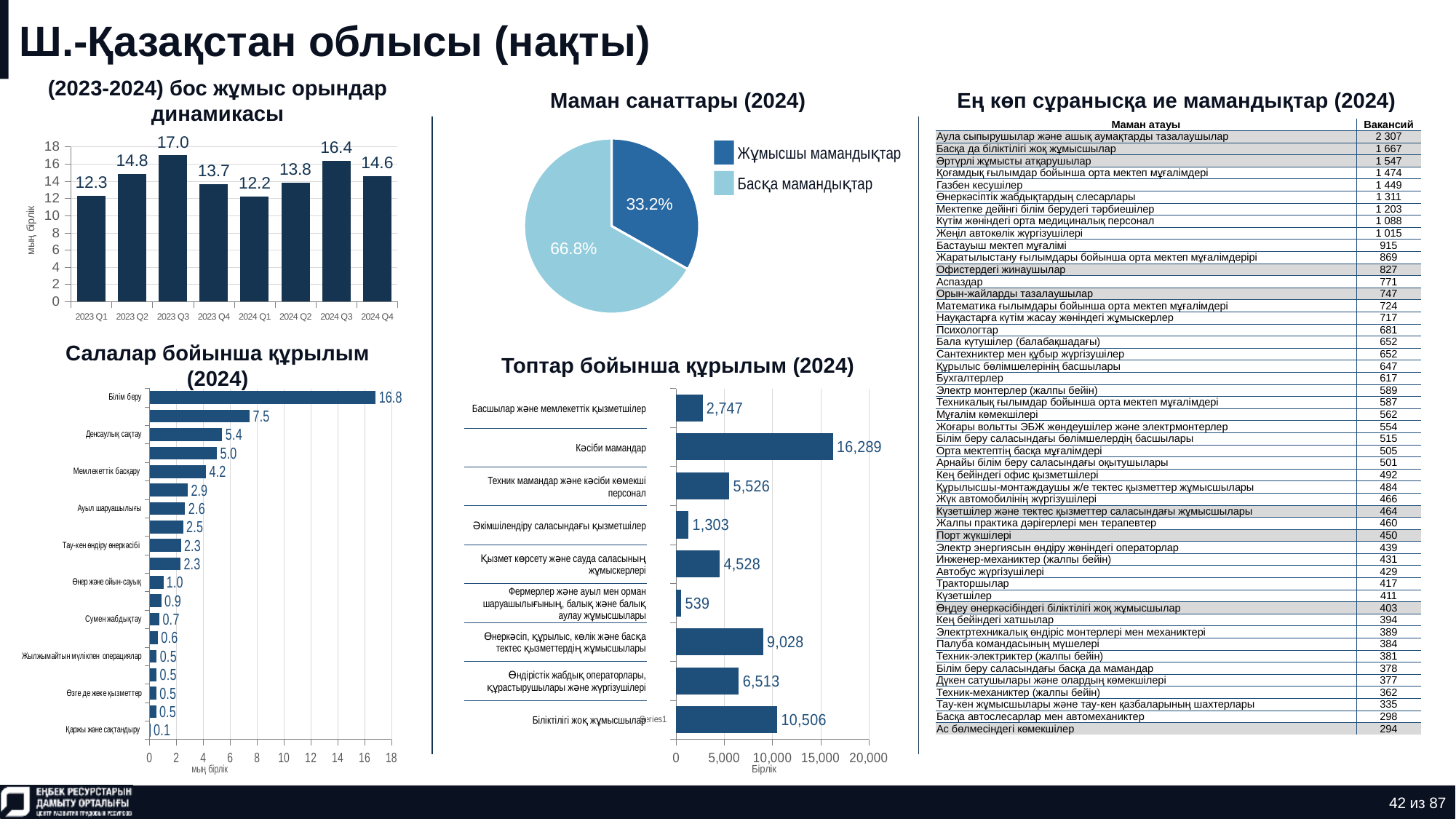
In the chart '(2023-2024) бос жұмыс орындар динамикасы', what is the value for 2023 Q3? 17.0 How many series does the legend of the pie chart 'Маман санаттары (2024)' list? 2 In the chart '(2023-2024) бос жұмыс орындар динамикасы', what is the difference between 2024 Q3 and 2024 Q4? 1.8 What kind of chart is 'Топтар бойынша құрылым (2024)'? bar chart In the chart 'Салалар бойынша құрылым (2024)', which of Денсаулық сақтау or Мемлекеттік басқару has the larger value? Денсаулық сақтау In the pie chart 'Маман санаттары (2024)', what share is Жұмысшы мамандықтар? 33.2% In the chart 'Топтар бойынша құрылым (2024)', what is the value for Кәсіби мамандар? 16,289 How many quarters are shown in the chart '(2023-2024) бос жұмыс орындар динамикасы'? 8 In the chart 'Салалар бойынша құрылым (2024)', what is the value for Білім беру? 16.8 How many categories are shown in the chart 'Топтар бойынша құрылым (2024)'? 9 In the chart '(2023-2024) бос жұмыс орындар динамикасы', which quarter has the lowest value? 2024 Q1 In the chart 'Топтар бойынша құрылым (2024)', which category has the lowest value? Фермерлер және ауыл мен орман шаруашылығының, балық және балық аулау жұмысшылары